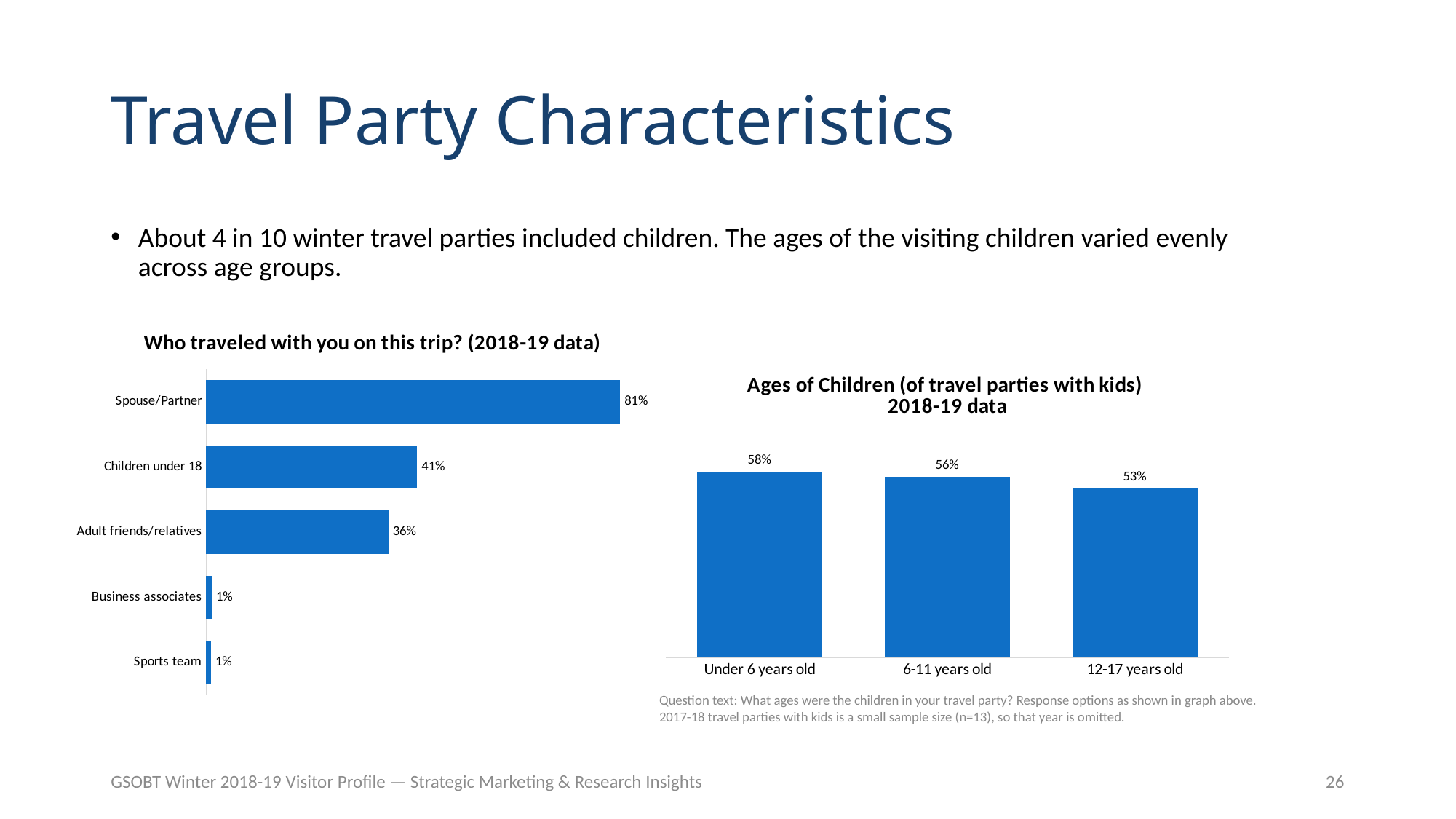
In the 'Ages of Children' chart, do the values rise or fall from left to right across the age groups? Fall In the 'Who traveled with you on this trip?' chart, what percentage of travel parties included a Spouse/Partner? 81% In the 'Ages of Children' chart, what is the difference between Under 6 years old and 12-17 years old? 5% In the 'Who traveled with you on this trip?' chart, what is the value for Adult friends/relatives? 36% In the 'Who traveled with you on this trip?' chart, which is larger: Children under 18 or Adult friends/relatives? Children under 18 What kind of chart is the 'Who traveled with you on this trip?' chart? Bar chart In the 'Ages of Children' chart, what is the value for 6-11 years old? 56% In the 'Ages of Children' chart, which age group has the lowest value? 12-17 years old In the 'Who traveled with you on this trip?' chart, what is the difference between Spouse/Partner and Children under 18? 40% In the 'Ages of Children' chart, how many age groups are shown? 3 In the 'Who traveled with you on this trip?' chart, how many categories are shown? 5 In the 'Who traveled with you on this trip?' chart, which category has the highest value? Spouse/Partner